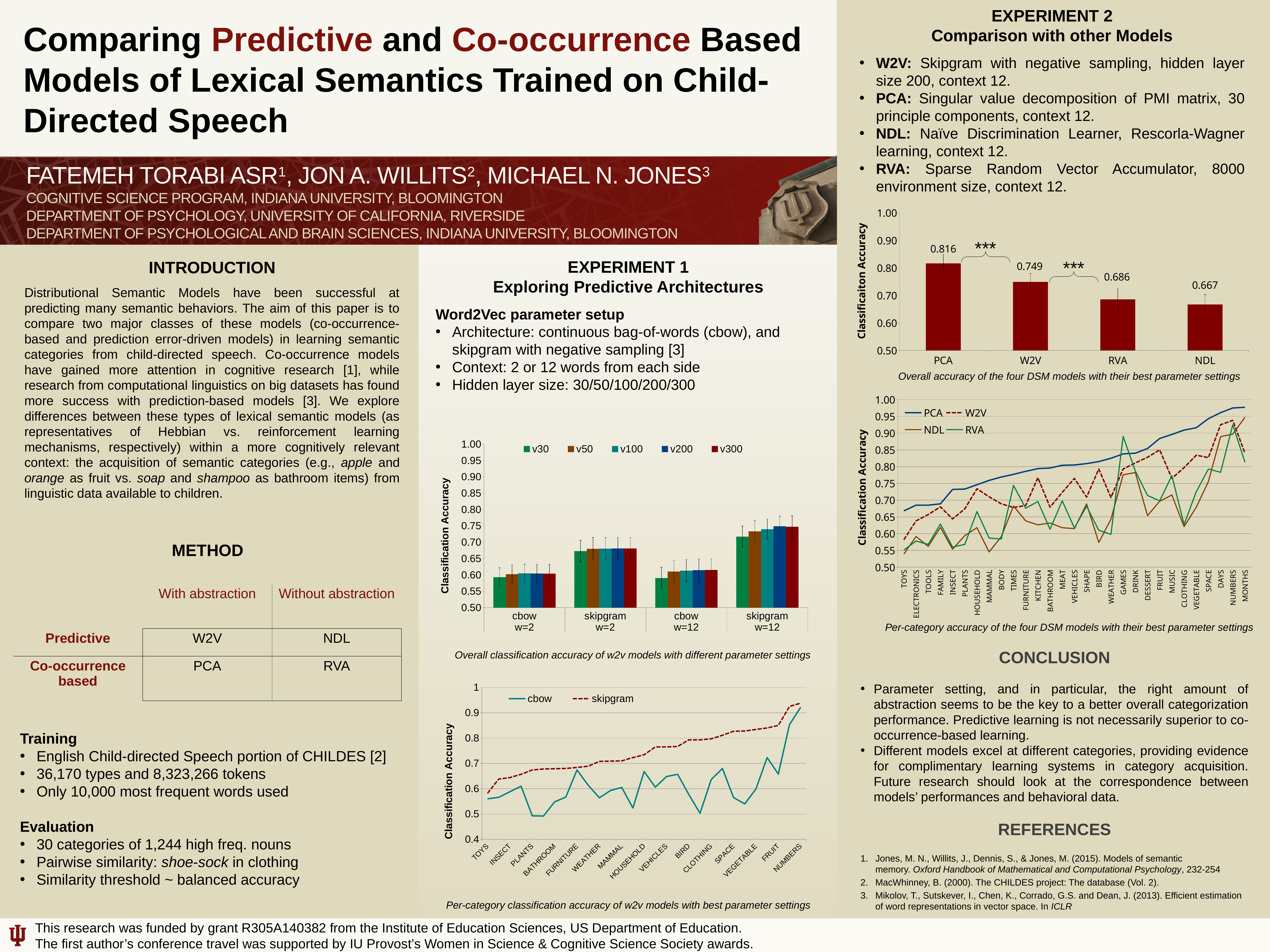
In the line chart titled 'Per-category accuracy of the four DSM models with their best parameter settings', which series is drawn with a dashed line? W2V In the bar chart titled 'Overall accuracy of the four DSM models with their best parameter settings', how many models are plotted? 4 In the bar chart titled 'Overall classification accuracy of w2v models with different parameter settings', which parameter setting group has the highest accuracies? skipgram w=12 In the bar chart titled 'Overall accuracy of the four DSM models with their best parameter settings', what is the classification accuracy for NDL? 0.667 In the bar chart titled 'Overall accuracy of the four DSM models with their best parameter settings', what is the difference between the PCA and W2V accuracies? 0.067 In the bar chart titled 'Overall accuracy of the four DSM models with their best parameter settings', what is the classification accuracy for PCA? 0.816 In the bar chart titled 'Overall accuracy of the four DSM models with their best parameter settings', which model has the lowest accuracy? NDL In the bar chart titled 'Overall accuracy of the four DSM models with their best parameter settings', which model has the highest accuracy? PCA In the bar chart titled 'Overall classification accuracy of w2v models with different parameter settings', how many series does the legend list? 5 In the bar chart titled 'Overall classification accuracy of w2v models with different parameter settings', is the v30 value for cbow w=2 greater or less than 0.65? less In the bar chart titled 'Overall accuracy of the four DSM models with their best parameter settings', which has the higher accuracy, W2V or RVA? W2V In the line chart titled 'Per-category classification accuracy of w2v models with best parameter settings', how many series does the legend list? 2